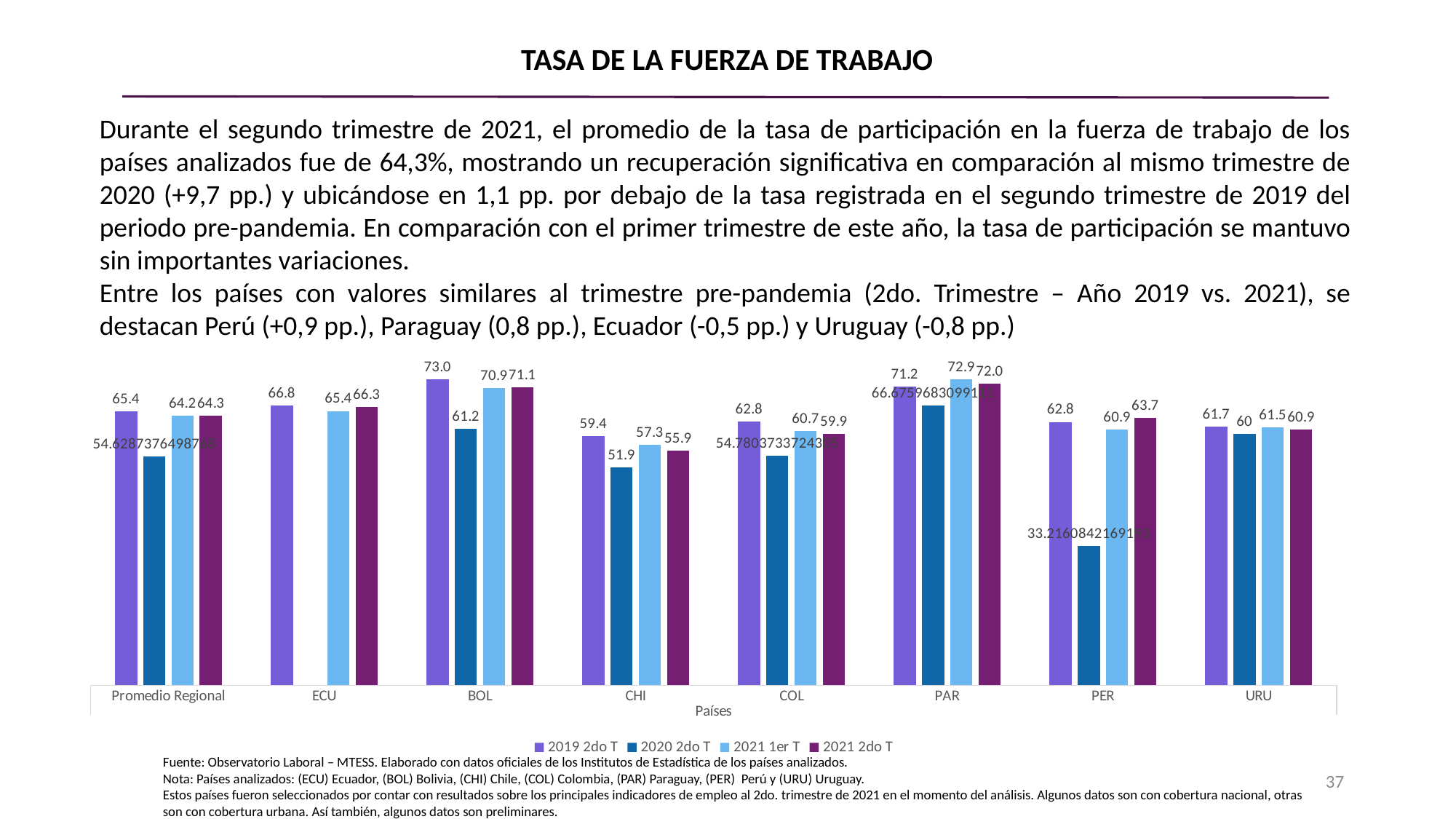
For PAR, which is larger: the 2021 1er T value or the 2021 2do T value? 2021 1er T Which category has the lowest value in the 2020 2do T series? PER How many categories are shown along the x axis of the chart? 8 What is the title of the x axis of the chart? Países What is the value for CHI in the 2020 2do T series? 51.9 What kind of chart is shown on the slide? bar chart What is the value for BOL in the 2019 2do T series? 73.0 Which category has the highest value in the 2019 2do T series? BOL What is the difference between the 2019 2do T value and the 2021 2do T value for BOL? 1.9 What is the value for PER in the 2021 2do T series? 63.7 What is the value for URU in the 2020 2do T series? 60 How many series does the legend of the chart list? 4